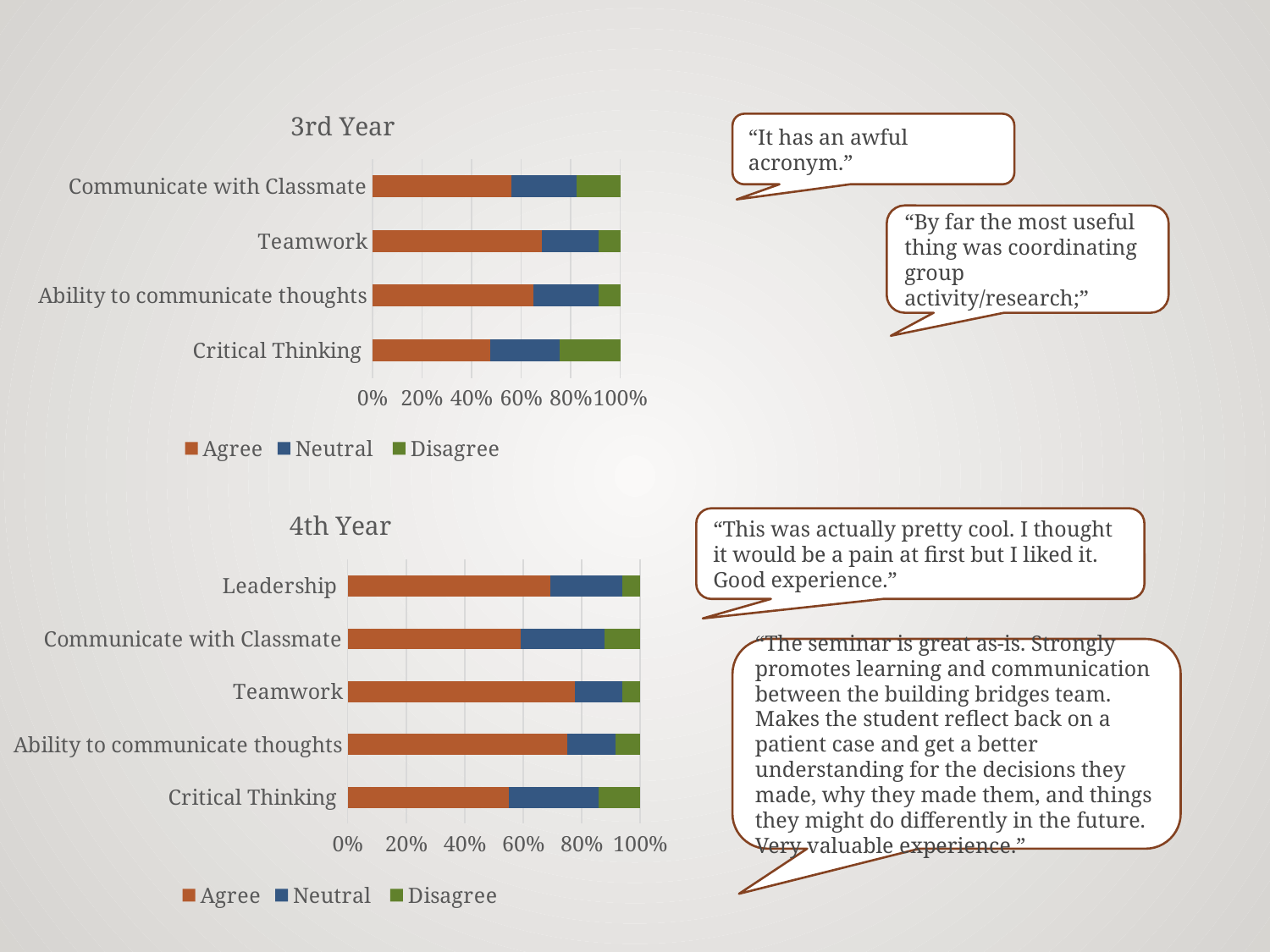
In the 3rd Year chart, which category has the largest Disagree share? Critical Thinking In the 4th Year chart, is the Agree value for Leadership greater or less than 60%? greater In the 4th Year chart, is the Agree value for Teamwork greater or less than 60%? greater How many categories does the 3rd Year chart show? 4 In the 3rd Year chart, is the Agree value for Teamwork greater or less than 60%? greater In the 3rd Year chart, which has the larger Agree share: Teamwork or Critical Thinking? Teamwork Which category appears in the 4th Year chart but not in the 3rd Year chart? Leadership How many categories does the 4th Year chart show? 5 In the 4th Year chart, which has the larger Agree share: Leadership or Critical Thinking? Leadership How many series does the legend of the 4th Year chart list? 3 What kind of chart is the 3rd Year chart? Bar chart